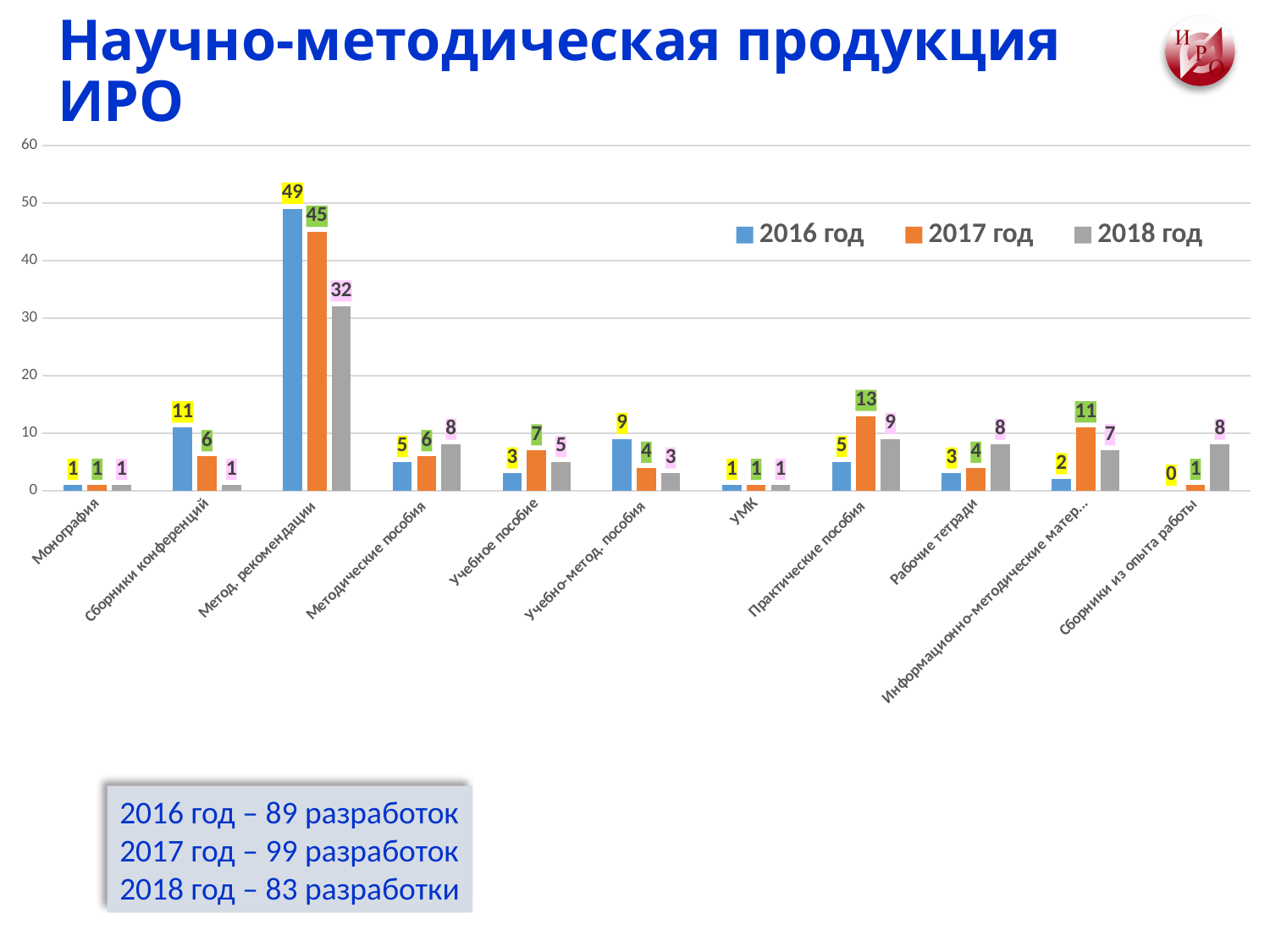
How many categories are shown on the x axis? 11 Which category has the highest value in the 2018 год series? Метод. рекомендации What is the value for Метод. рекомендации in the 2016 год series? 49 Which is larger for Сборники конференций: the 2016 год value or the 2017 год value? 2016 год Is the 2017 год value for Метод. рекомендации greater or less than 40? greater What is the value for Сборники из опыта работы in the 2018 год series? 8 What is the value for Практические пособия in the 2017 год series? 13 What is the difference between the 2016 год and 2018 год values for Метод. рекомендации? 17 What is the title of the slide? Научно-методическая продукция ИРО How many series does the legend list? 3 What kind of chart is shown on the slide? bar chart Which category has the lowest value in the 2016 год series? Сборники из опыта работы